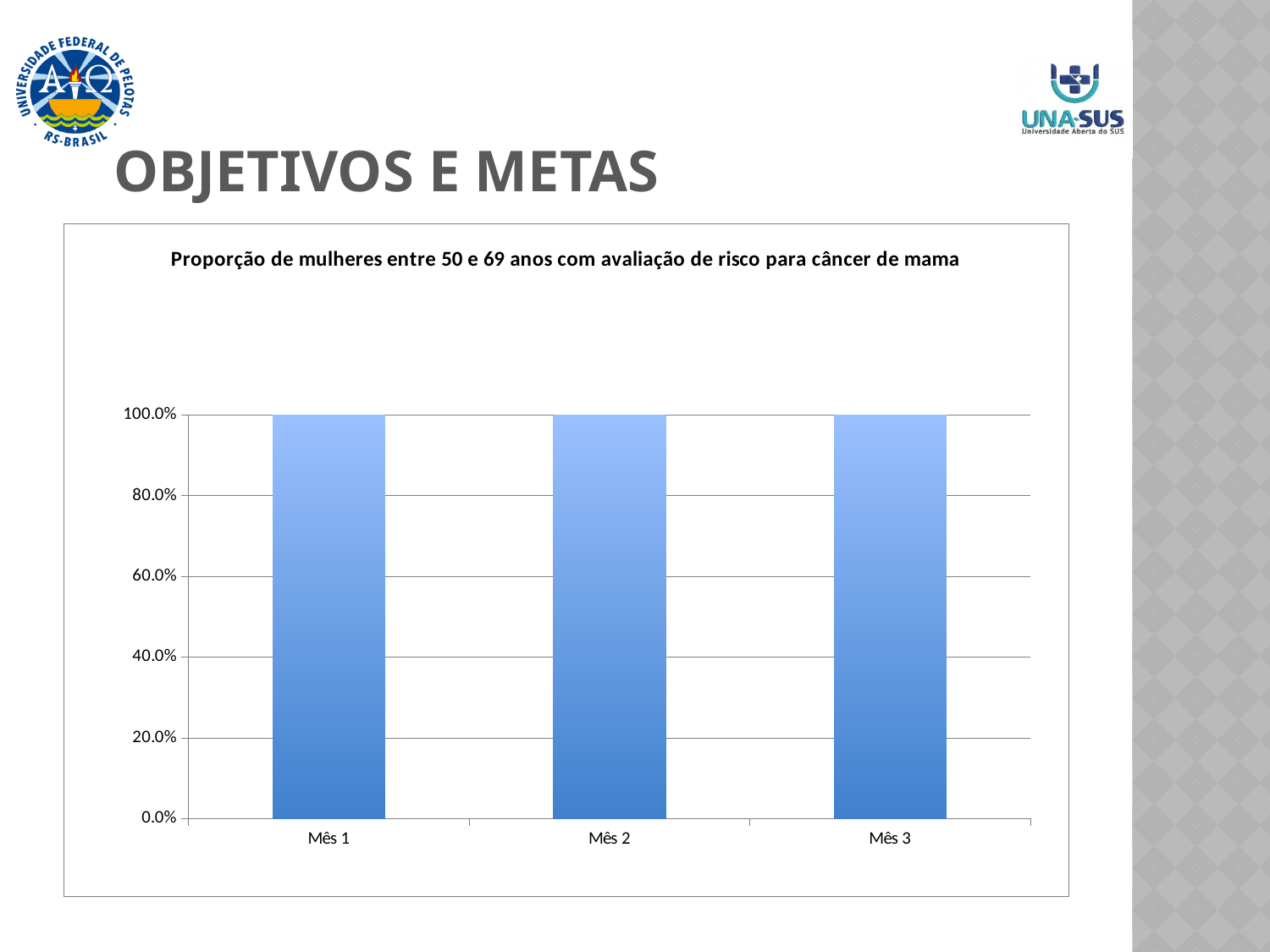
What is the difference between the values for Mês 1 and Mês 3? 0.0% Is the value for Mês 2 greater or less than 80.0%? greater Do the values rise, fall, or stay the same from Mês 1 to Mês 3? Stay the same What type of chart is shown on the slide? Bar chart What is the value for Mês 1? 100.0% How many categories (months) are shown on the x axis? 3 What is the value for Mês 2? 100.0% What is the title of the chart? Proporção de mulheres entre 50 e 69 anos com avaliação de risco para câncer de mama What is the highest value shown on the y axis? 100.0% Is the value for Mês 3 greater or less than 60.0%? greater What is the value for Mês 3? 100.0%